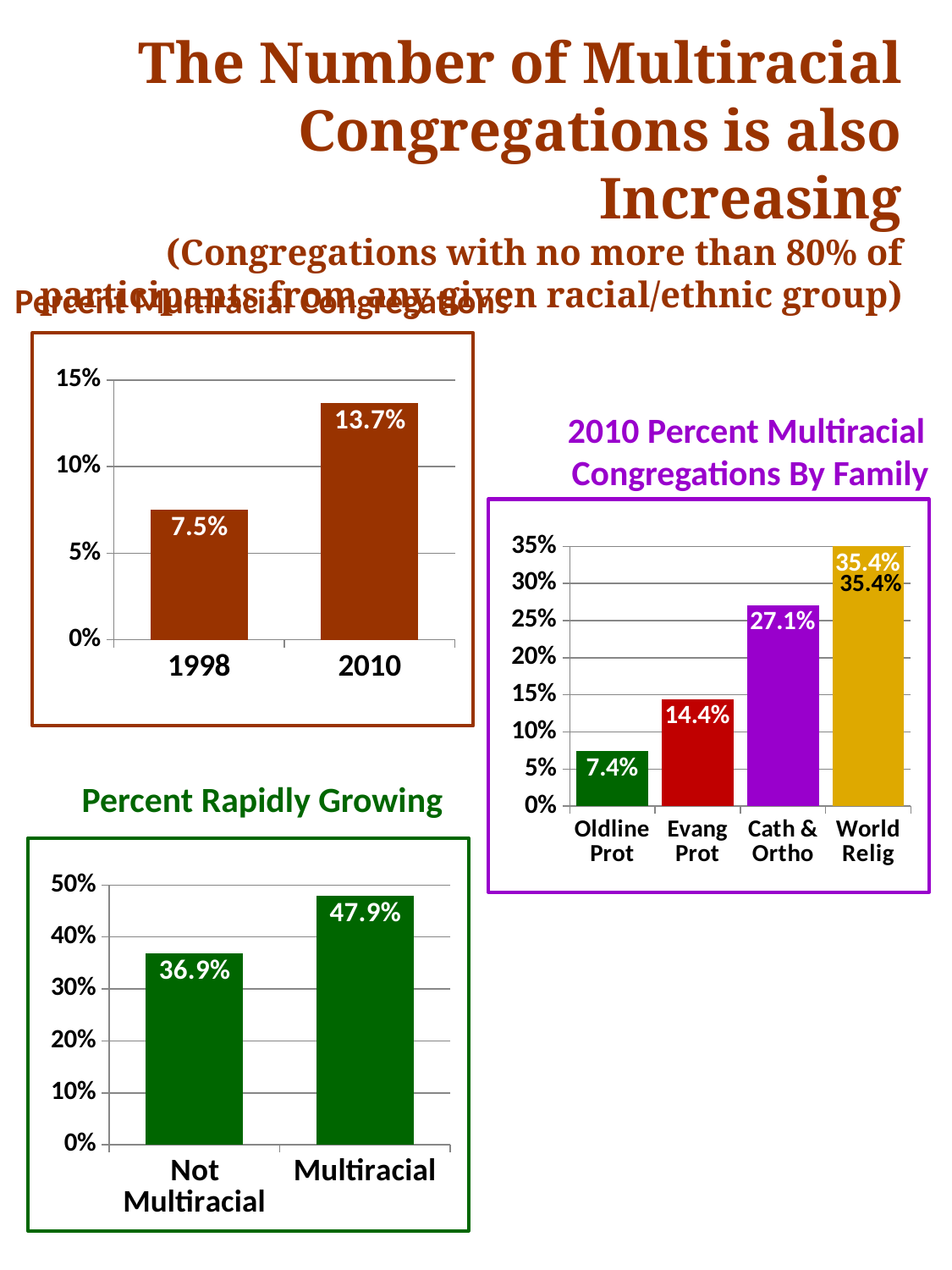
In the '2010 Percent Multiracial Congregations By Family' chart, which family has the highest value? World Relig In the '2010 Percent Multiracial Congregations By Family' chart, which family has the lowest value? Oldline Prot In the top-left chart, what is the value for 1998? 7.5% In the 'Percent Rapidly Growing' chart, what is the value for Not Multiracial? 36.9% How many categories are shown in the '2010 Percent Multiracial Congregations By Family' chart? 4 In the top-left chart, what is the value for 2010? 13.7% In the '2010 Percent Multiracial Congregations By Family' chart, what is the value for Cath & Ortho? 27.1% What kind of chart is the '2010 Percent Multiracial Congregations By Family' chart? bar chart In the 'Percent Rapidly Growing' chart, what is the value for Multiracial? 47.9% In the 'Percent Rapidly Growing' chart, which category is higher, Not Multiracial or Multiracial? Multiracial In the top-left chart, what is the difference between the 2010 and 1998 values? 6.2% In the top-left chart, do the values rise or fall from 1998 to 2010? rise